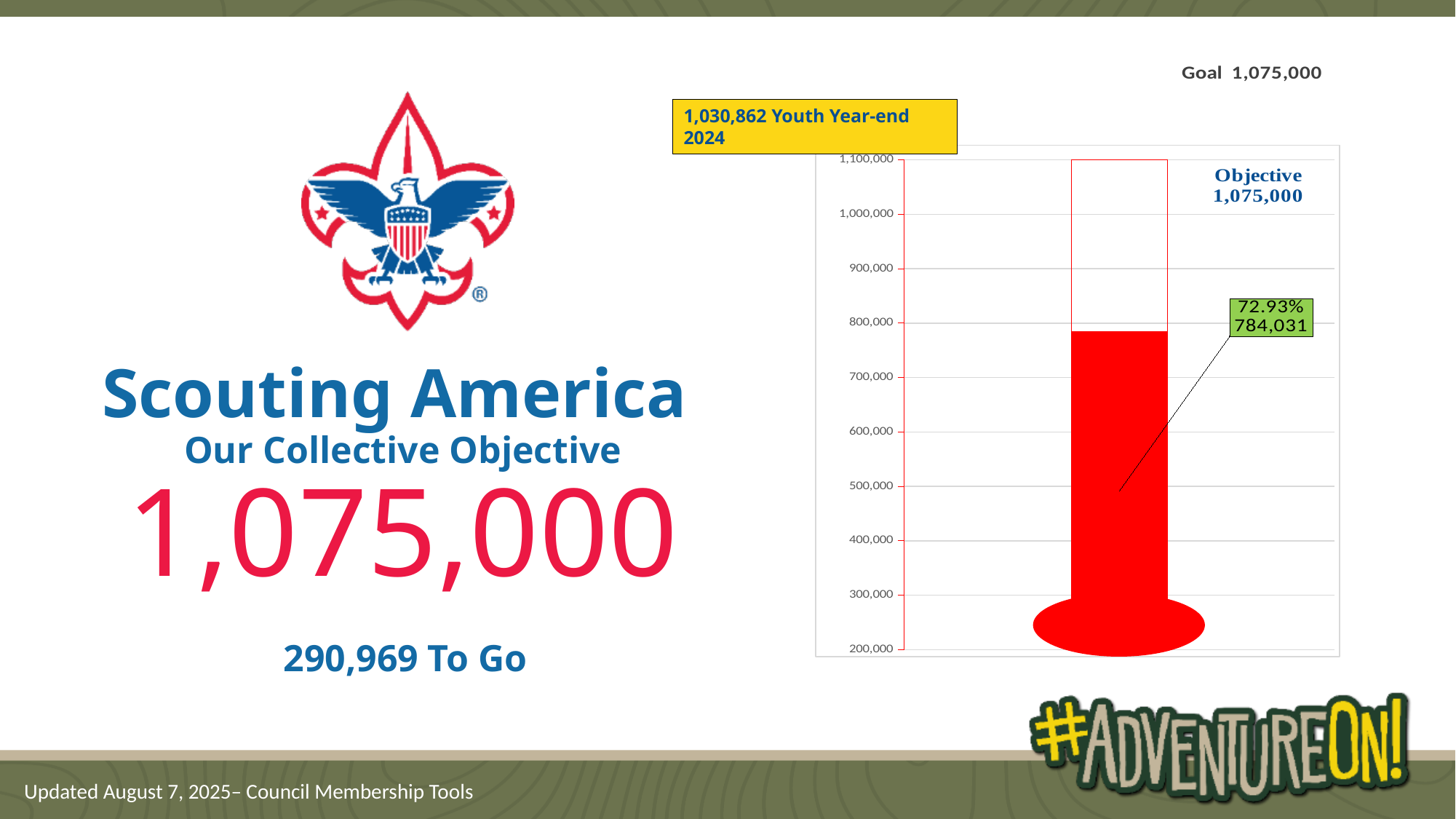
Is the current value shown by the red bar greater or less than 800,000? less What kind of chart is shown on the right side of the slide? bar chart (thermometer style) What colour is the filled portion of the thermometer bar? red What is the goal value printed above the chart? 1,075,000 How much more is the objective (1,075,000) than the current value (784,031) shown on the chart? 290,969 What value does the red bar in the thermometer chart reach, as shown by its data label? 784,031 What is the objective value labelled on the thermometer chart? 1,075,000 What percentage of the objective has been reached according to the chart's data label? 72.93% Is the current value shown by the red bar greater or less than 700,000? greater What is the lowest value shown on the chart's vertical axis? 200,000 Which is larger, the objective value or the current value shown by the red bar? the objective value What is the highest value shown on the chart's vertical axis? 1,100,000